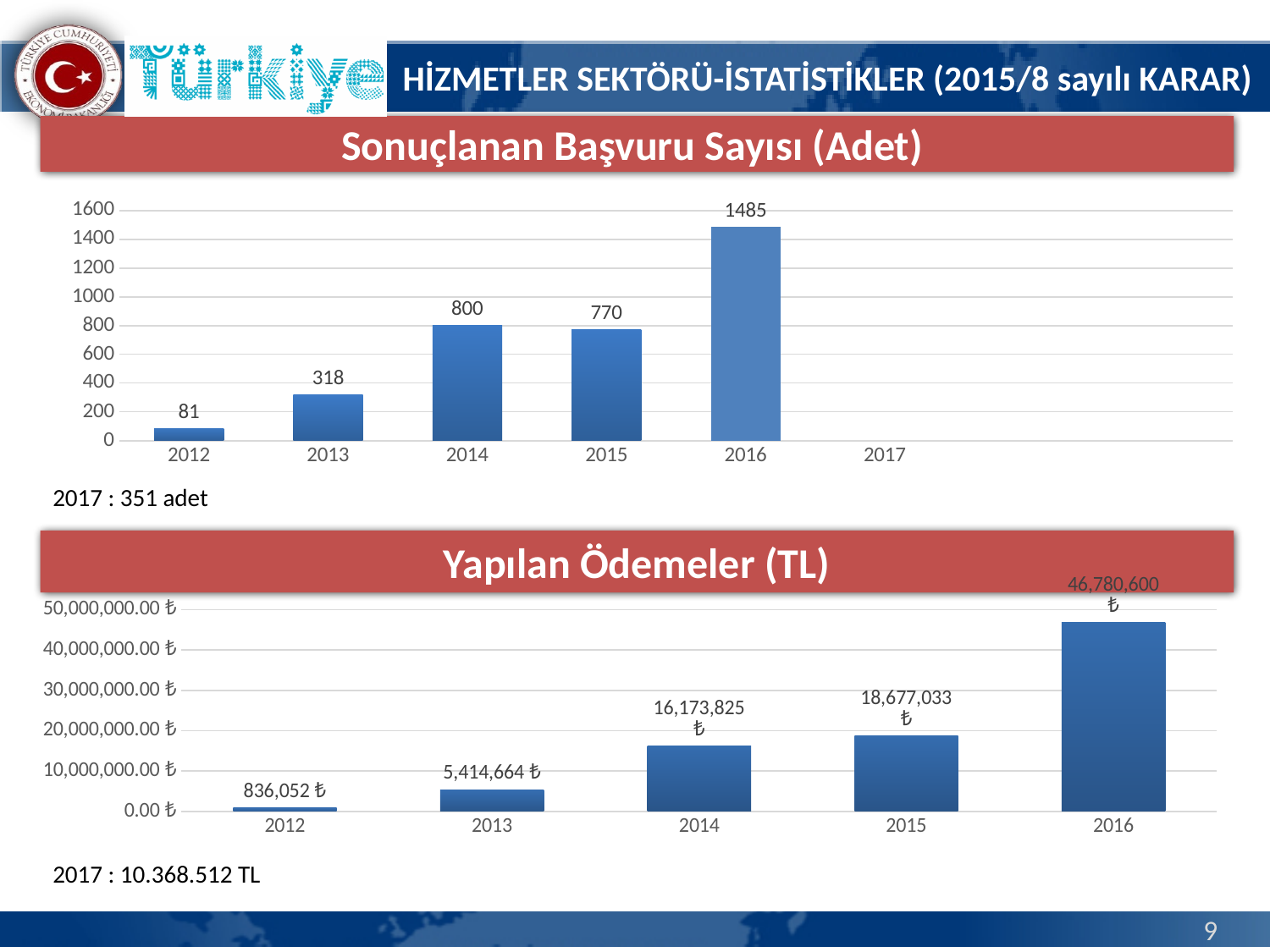
How many years are plotted as bars in the 'Yapılan Ödemeler (TL)' chart? 5 In the 'Yapılan Ödemeler (TL)' chart, what is the value for 2016? 46,780,600 ₺ In the 'Sonuçlanan Başvuru Sayısı (Adet)' chart, which year has the lowest plotted value? 2012 In the 'Sonuçlanan Başvuru Sayısı (Adet)' chart, which year has the highest value? 2016 In the 'Sonuçlanan Başvuru Sayısı (Adet)' chart, what is the value for 2016? 1485 What kind of chart is the 'Yapılan Ödemeler (TL)' chart? bar chart In the 'Yapılan Ödemeler (TL)' chart, do the values rise or fall from 2012 to 2016? rise In the 'Sonuçlanan Başvuru Sayısı (Adet)' chart, is the value for 2013 greater or less than 400? less In the 'Yapılan Ödemeler (TL)' chart, what is the value for 2014? 16,173,825 ₺ In the 'Sonuçlanan Başvuru Sayısı (Adet)' chart, what is the difference between the values for 2014 and 2015? 30 In the 'Sonuçlanan Başvuru Sayısı (Adet)' chart, what is the value for 2012? 81 In the 'Yapılan Ödemeler (TL)' chart, which is larger, the value for 2013 or the value for 2015? 2015